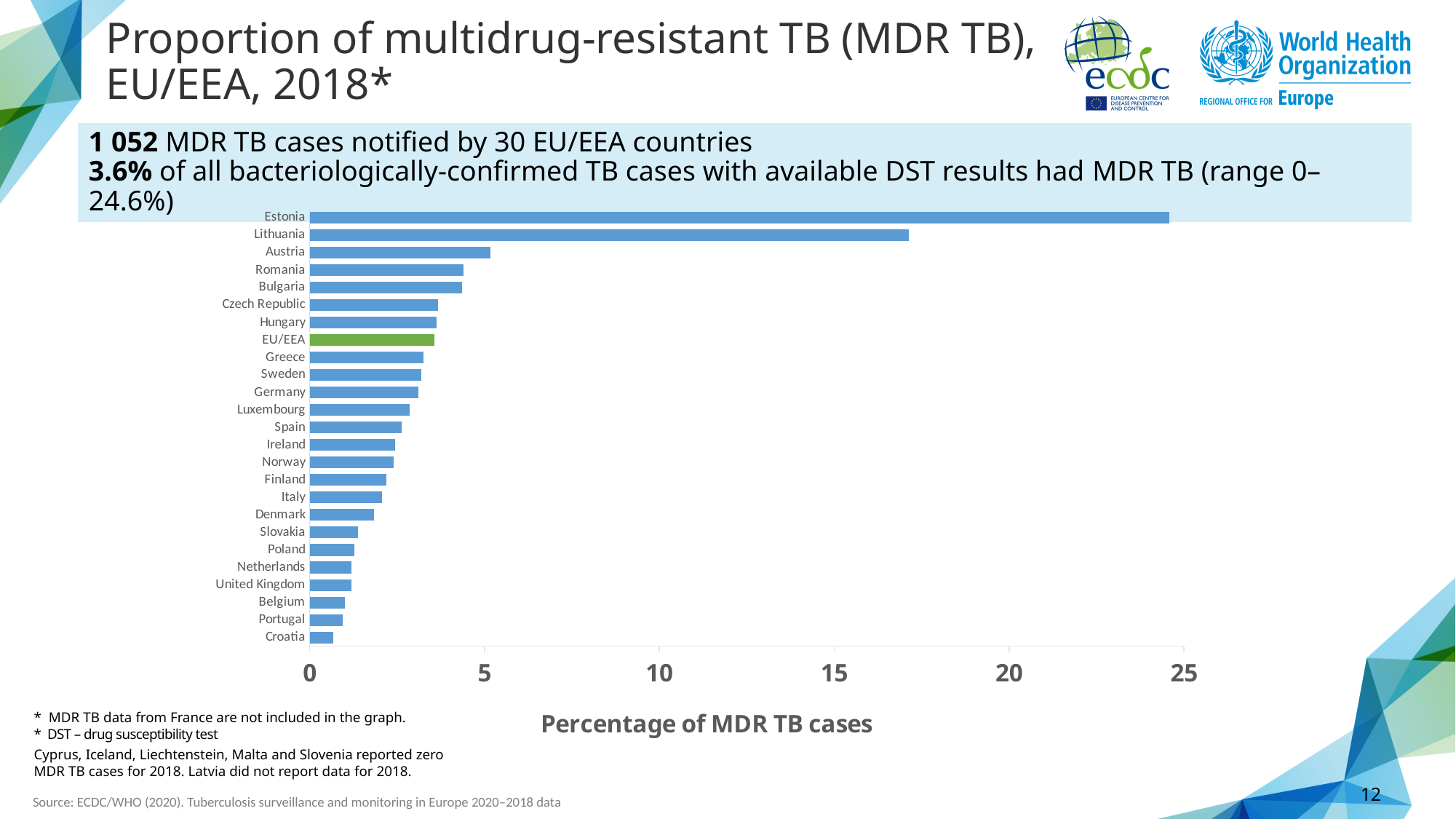
Which has a larger percentage of MDR TB cases, Austria or Croatia? Austria Is the value for Austria greater or less than 10? less How many bars (categories) are plotted in the chart? 25 What kind of chart is shown on the slide? bar chart Which has a larger percentage of MDR TB cases, Estonia or Lithuania? Estonia What is the title of the horizontal axis of the chart? Percentage of MDR TB cases Is the value for Croatia greater or less than 5? less Which country has the highest percentage of MDR TB cases in the chart? Estonia Is the value for Estonia greater or less than 20? greater Which country has the lowest percentage of MDR TB cases in the chart? Croatia